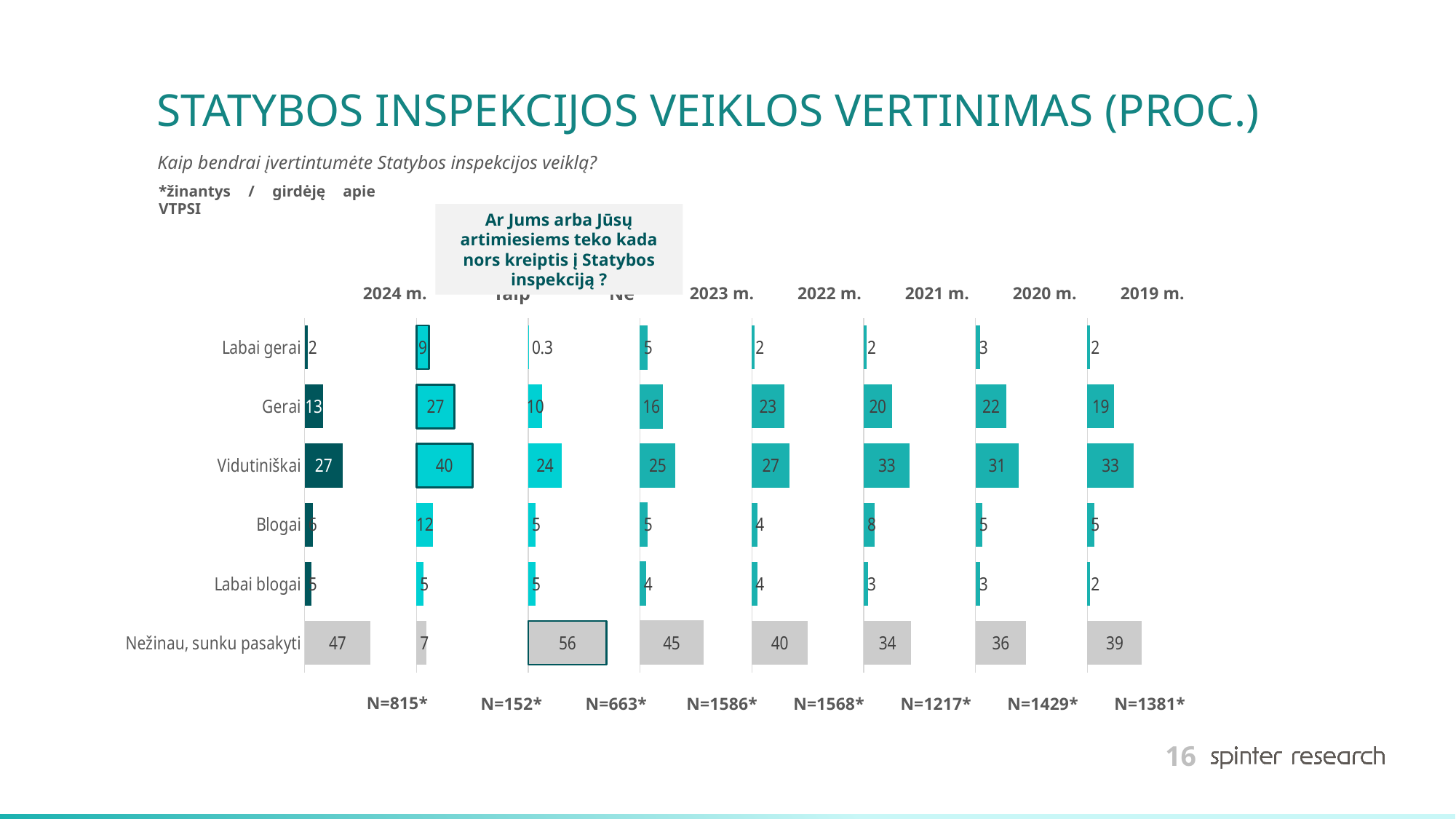
In the 2024 m. panel, what is the value for Vidutiniškai? 27 In the 2021 m. panel, what is the value for Blogai? 8 How many rating categories are listed on the left of the chart? 6 What is the difference between the Vidutiniškai values in the 2021 m. and 2020 m. panels? 2 What is the sample size (N) shown under the 2024 m. panel? N=815* In the 2020 m. panel, which category has the lowest value? Labai gerai and Labai blogai (both 3) In the 2022 m. panel, which category has the highest value? Nežinau, sunku pasakyti What is the difference between the Nežinau, sunku pasakyti values in the 2024 m. and 2019 m. panels? 8 What kind of chart is shown on the slide? Bar chart In the 2023 m. panel, what is the value for Nežinau, sunku pasakyti? 45 Which is larger: the Gerai value in the 2022 m. panel or in the 2023 m. panel? 2022 m. In the 2019 m. panel, what is the value for Gerai? 19